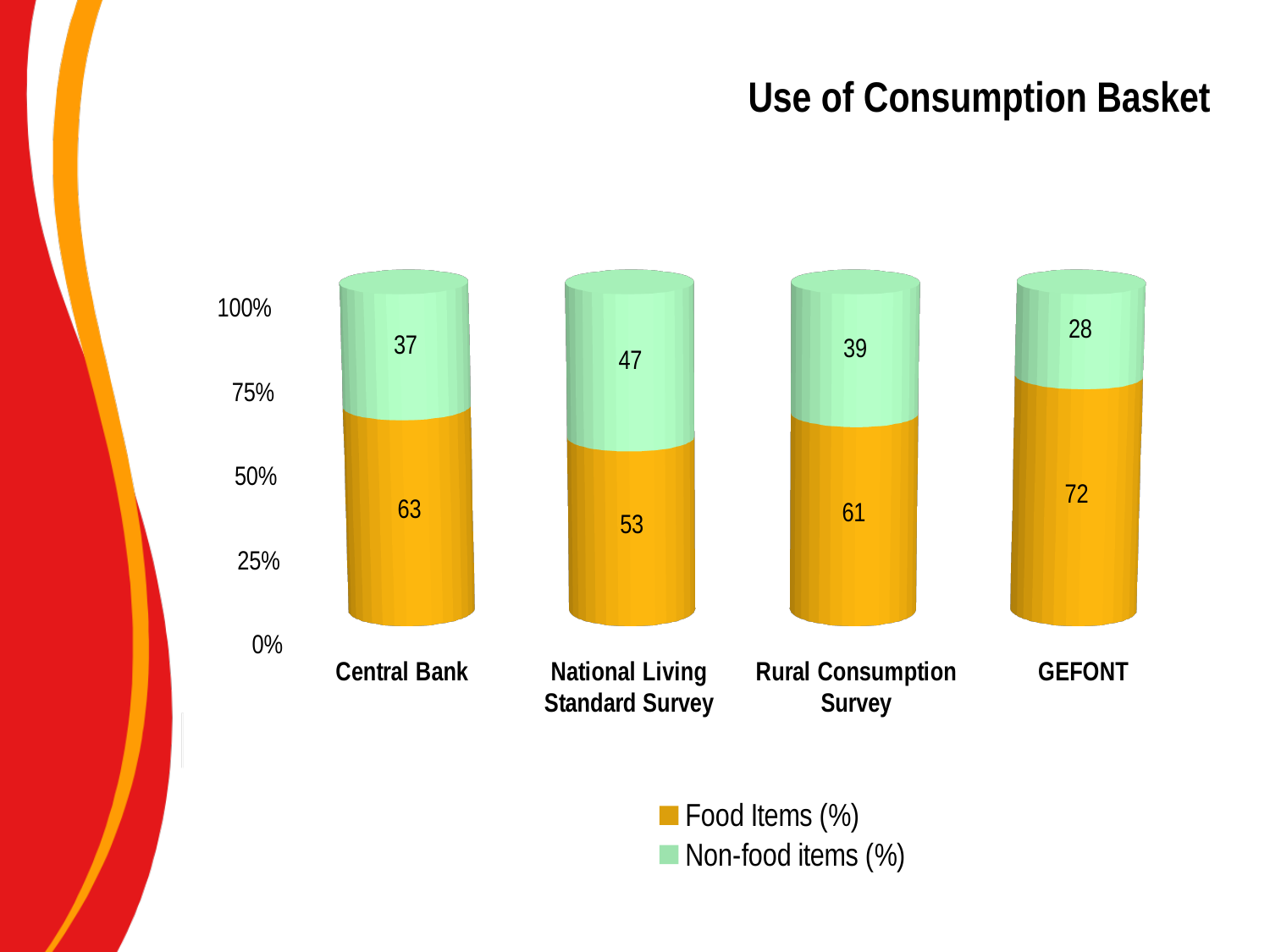
What is the Non-food items (%) value for Rural Consumption Survey? 39 Which category has the highest Food Items (%) value? GEFONT What is the Non-food items (%) value for National Living Standard Survey? 47 How many categories are shown on the x axis? 4 How many series does the legend list? 2 What is the Food Items (%) value for Central Bank? 63 What is the title of the chart? Use of Consumption Basket Which is larger: the Non-food items (%) value for Central Bank or for Rural Consumption Survey? Central Bank What is the Food Items (%) value for GEFONT? 72 What kind of chart is shown on the slide? Stacked bar chart Which category has the lowest Non-food items (%) value? GEFONT What is the difference between the Food Items (%) values for GEFONT and National Living Standard Survey? 19